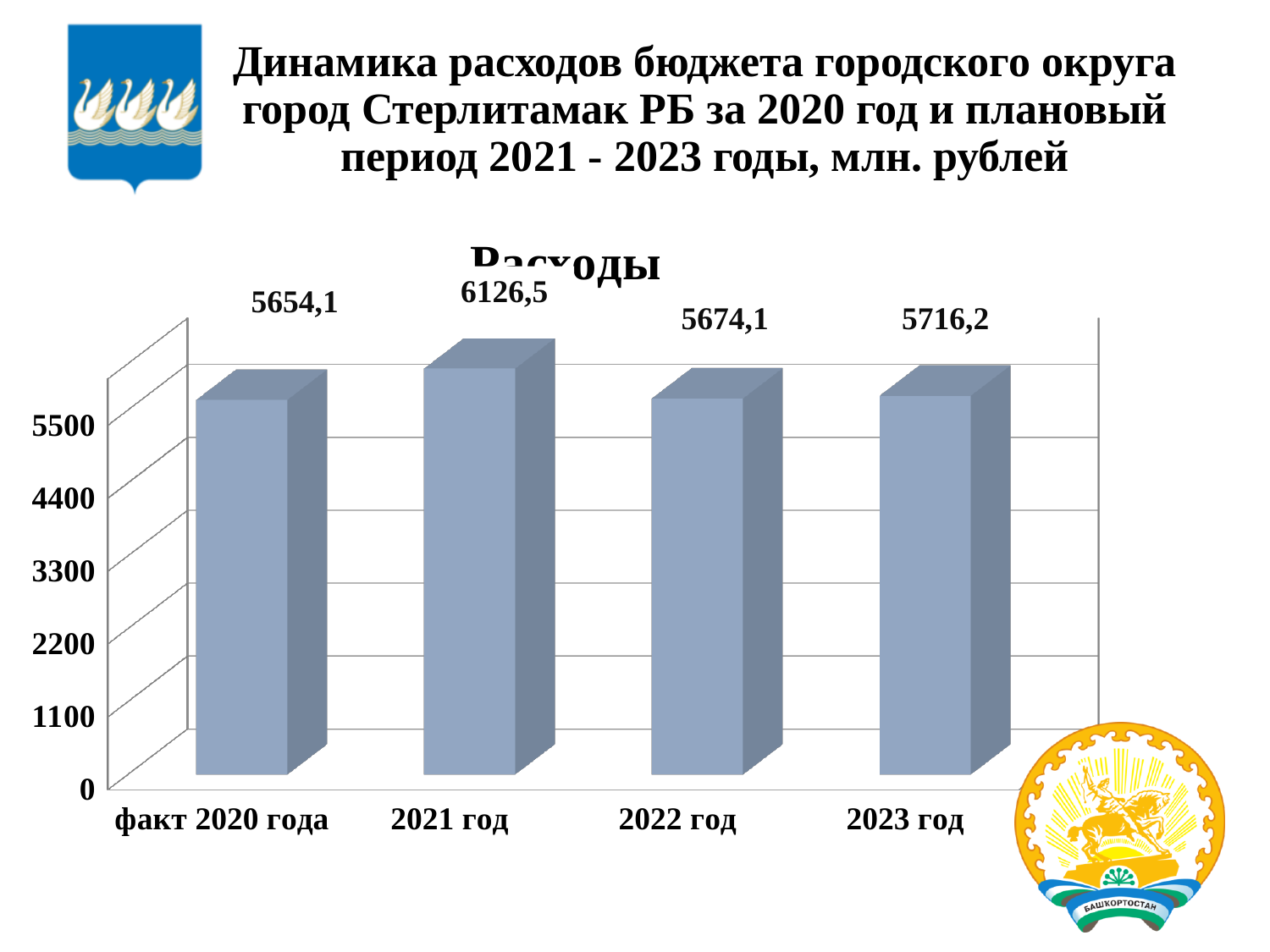
What kind of chart is shown on the slide? bar chart Is the value for 2021 год greater or less than 5500? greater How many categories are shown on the x axis? 4 Which category has the lowest value? факт 2020 года What is the difference between the values for 2023 год and 2022 год? 42,1 What is the value for факт 2020 года? 5654,1 What is the value for 2023 год? 5716,2 Which category has the highest value? 2021 год What is the value for 2022 год? 5674,1 What is the value for 2021 год? 6126,5 Which is larger, the value for 2022 год or the value for 2023 год? 2023 год What is the difference between the values for 2021 год and факт 2020 года? 472,4